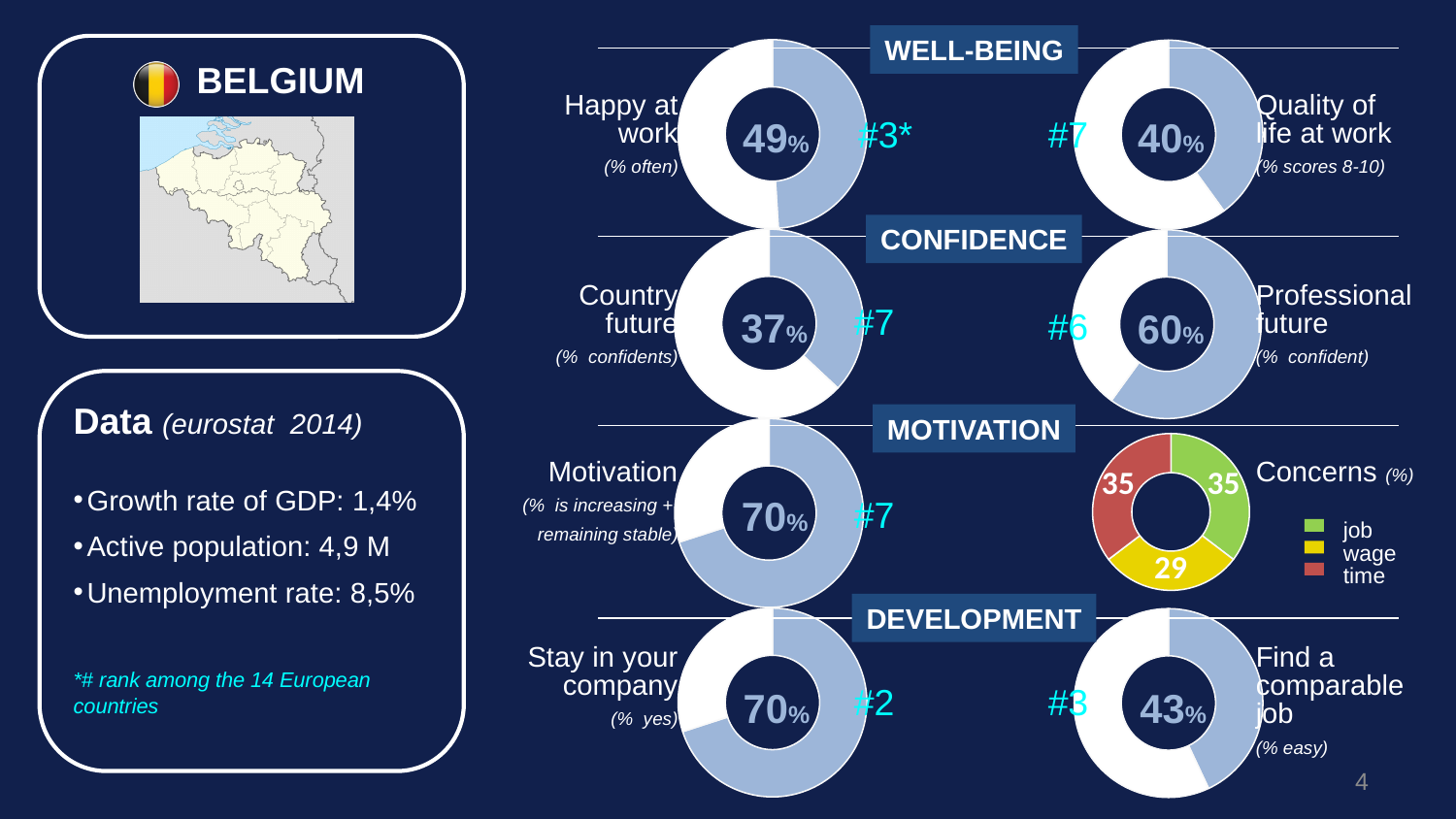
What is the difference between the percentage in the 'Stay in your company' chart and the percentage in the 'Find a comparable job' chart? 27% In the 'Concerns (%)' donut chart, how many categories does the legend list? 3 In the 'Find a comparable job' donut chart, what percentage is shown? 43% In the 'Country future' donut chart, what percentage is shown? 37% In the 'Quality of life at work' donut chart, what percentage is shown? 40% In the 'Concerns (%)' donut chart, which category has the lowest value? wage In the 'Concerns (%)' donut chart, what value is shown for wage? 29 Which is larger: the percentage in the 'Professional future' chart or the percentage in the 'Country future' chart? Professional future In the 'Happy at work' donut chart, what percentage is shown? 49% In the 'Professional future' donut chart, what percentage is shown? 60% In the 'Concerns (%)' donut chart, what is the difference between the value for job and the value for wage? 6 What type of chart is used for 'Motivation'? Donut chart